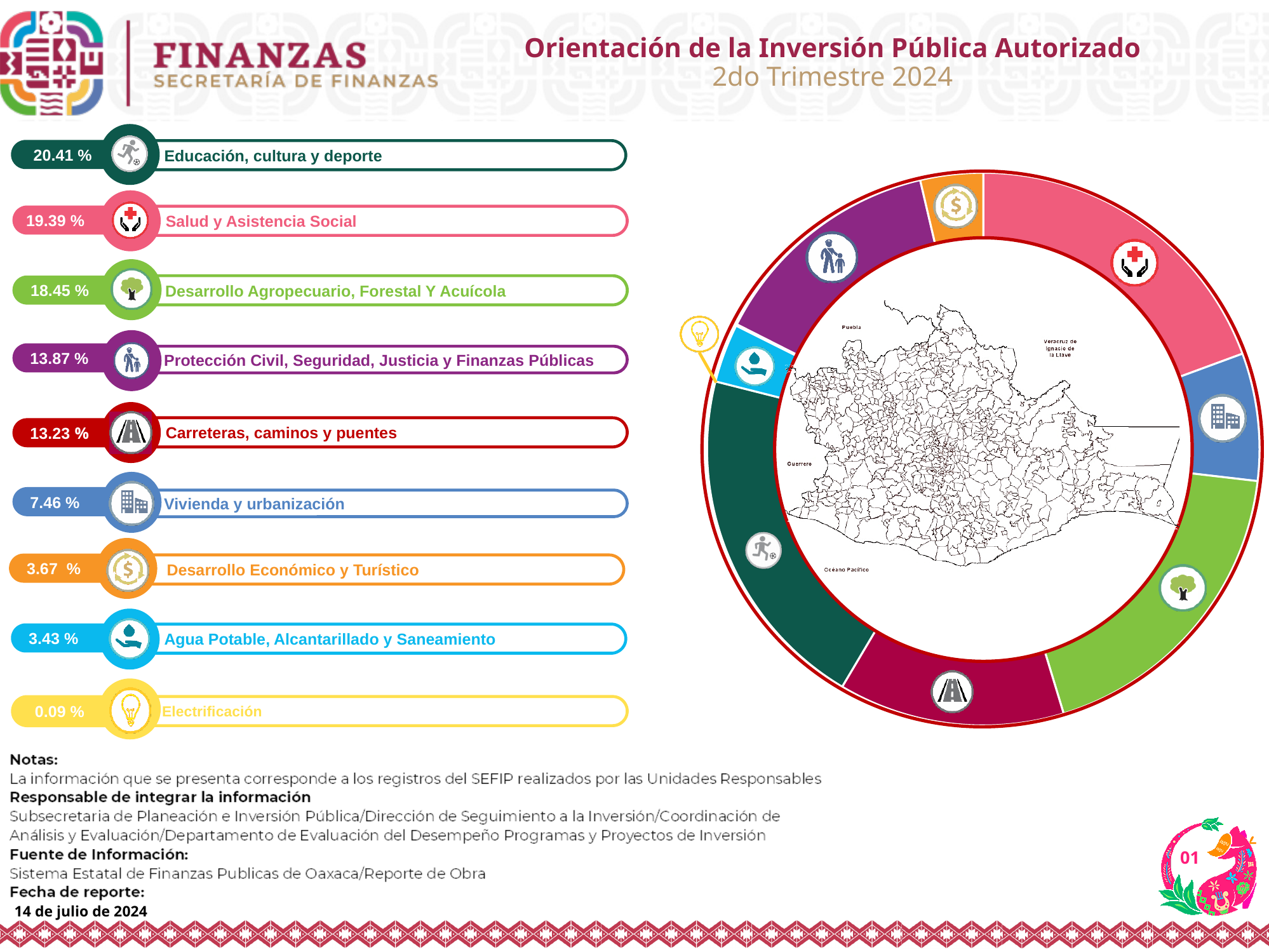
Which has a larger share, Desarrollo Agropecuario, Forestal Y Acuícola or Protección Civil, Seguridad, Justicia y Finanzas Públicas? Desarrollo Agropecuario, Forestal Y Acuícola What is the difference in percentage points between Educación, cultura y deporte and Salud y Asistencia Social? 1.02 % What percentage is shown for Vivienda y urbanización? 7.46 % Which category has the lowest percentage? Electrificación What percentage is shown for Agua Potable, Alcantarillado y Saneamiento? 3.43 % What kind of chart is shown on the slide? Doughnut (pie) chart Which category has the highest percentage? Educación, cultura y deporte What is the difference in percentage points between Vivienda y urbanización and Desarrollo Económico y Turístico? 3.79 % What is the title of the slide's chart? Orientación de la Inversión Pública Autorizado 2do Trimestre 2024 What percentage is shown for Educación, cultura y deporte? 20.41 % What percentage is shown for Carreteras, caminos y puentes? 13.23 % How many categories are shown in the chart? 9